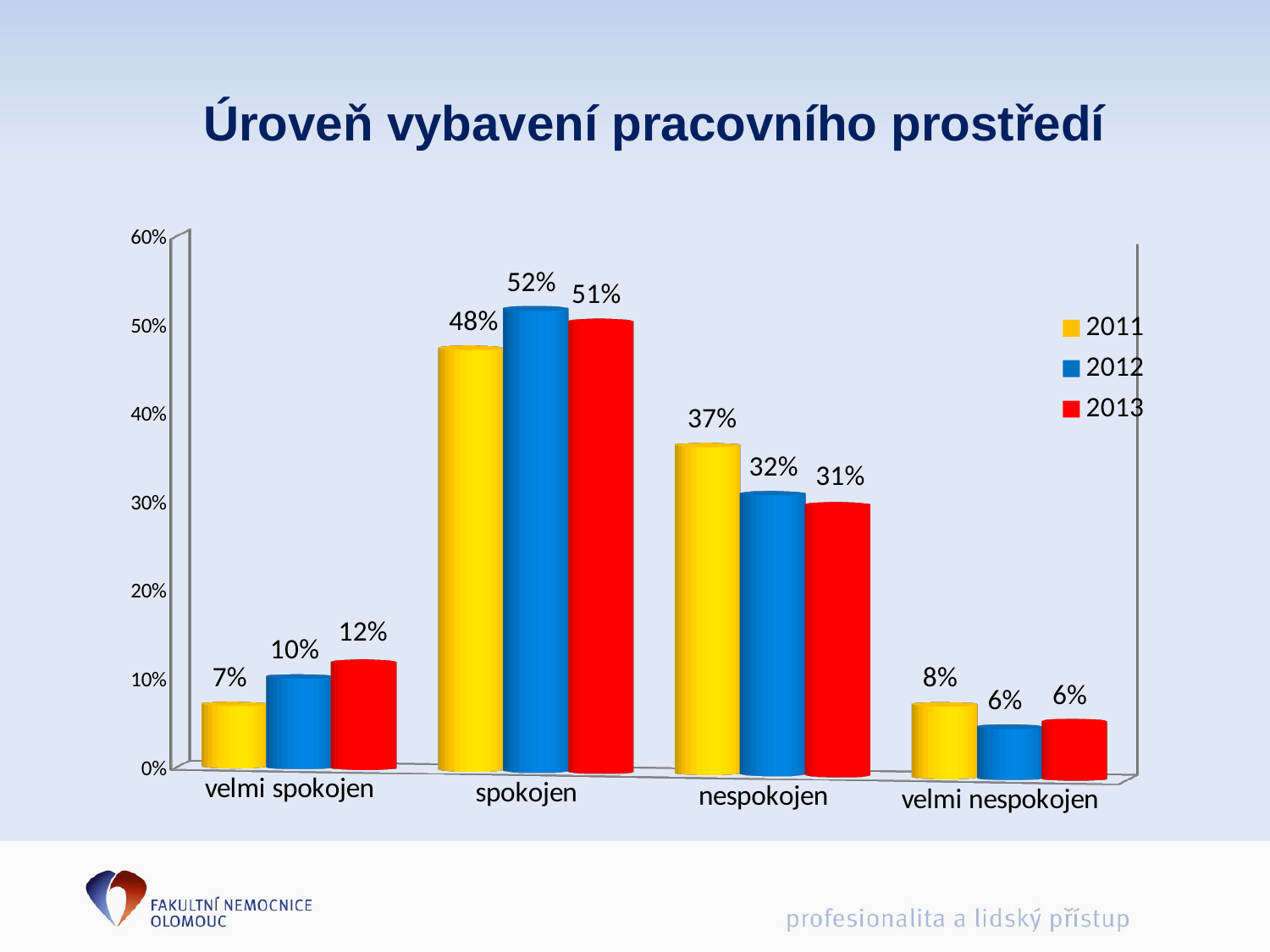
Which is larger: the 2011 value for 'velmi spokojen' or the 2013 value for 'velmi spokojen'? 2013 What is the value for 'spokojen' in 2012? 52% Which category has the lowest value in 2013? velmi nespokojen How many categories are shown on the x axis? 4 What is the value for 'velmi nespokojen' in 2011? 8% How many series does the legend list? 3 What is the title of the chart? Úroveň vybavení pracovního prostředí What is the value for 'nespokojen' in 2013? 31% Which category has the highest value in 2011? spokojen Does the value for 'velmi spokojen' rise or fall from 2011 to 2013? rise What kind of chart is shown on the slide? bar chart What is the difference between the 2011 and 2013 values for 'nespokojen'? 6%